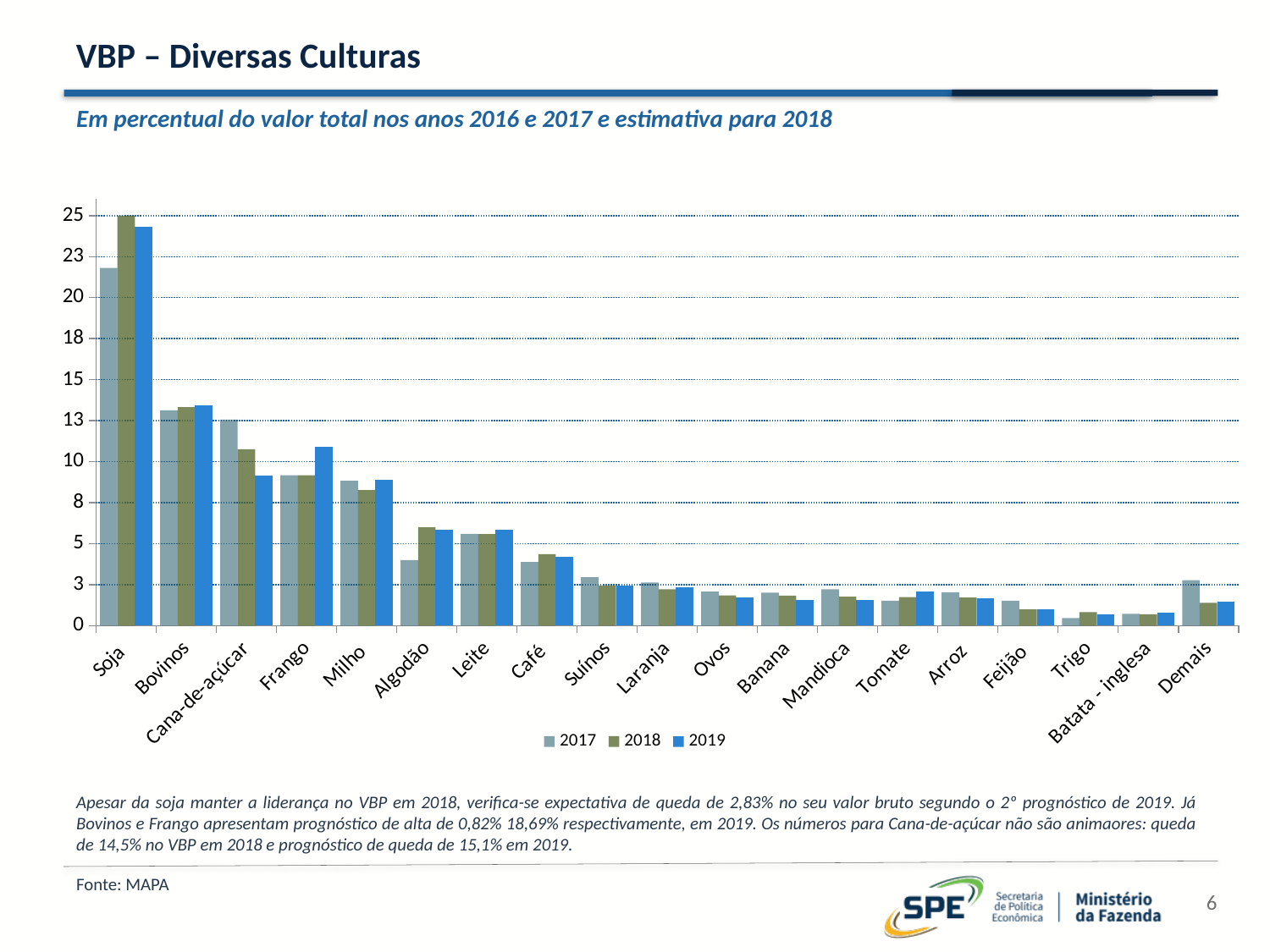
For Cana-de-açúcar, which is larger: the 2017 value or the 2019 value? 2017 Do the 2018 values generally rise or fall along the x axis from Soja to Batata - inglesa? fall Is the 2019 value for Frango greater or less than 10? greater Which category has the highest value for the 2018 series? Soja How many series does the legend list? 3 Is the 2017 value for Soja greater or less than 20? greater How many categories are shown on the x axis? 19 Which category has the lowest value for the 2017 series? Trigo What are the three entries listed in the legend? 2017, 2018, 2019 Is the 2019 value for Cana-de-açúcar greater or less than 10? less What kind of chart is shown on the slide? bar chart